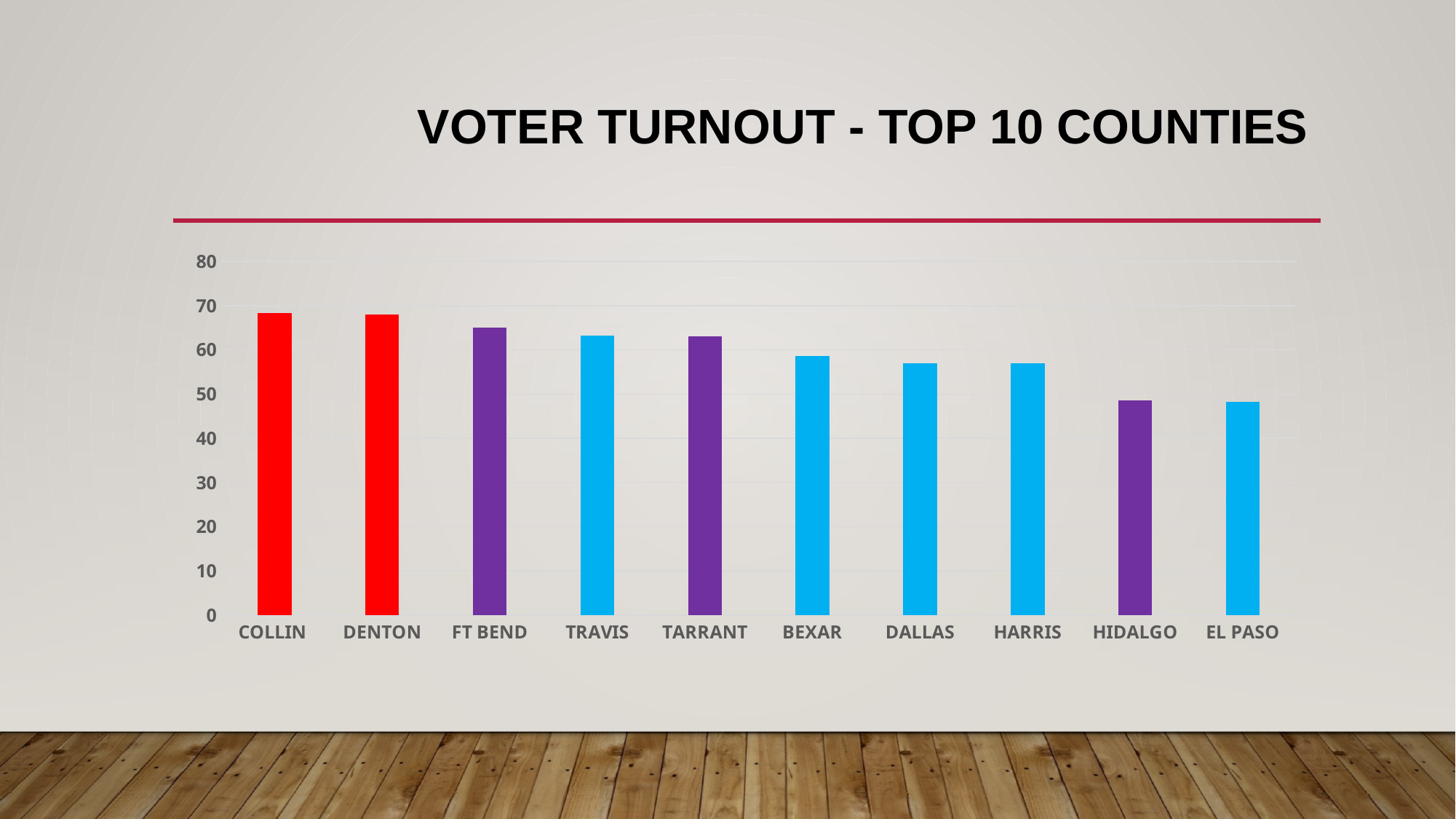
Is the value for FT BEND greater or less than 60? greater Which has a higher value, HARRIS or HIDALGO? HARRIS Is the value for DALLAS greater or less than 50? greater Do the values generally rise or fall from left to right across the counties? fall Is the value for HIDALGO greater or less than 50? less What is the title of the chart? VOTER TURNOUT - TOP 10 COUNTIES Which has a higher value, COLLIN or BEXAR? COLLIN How many counties are shown in the chart? 10 What kind of chart is shown on the slide? bar chart